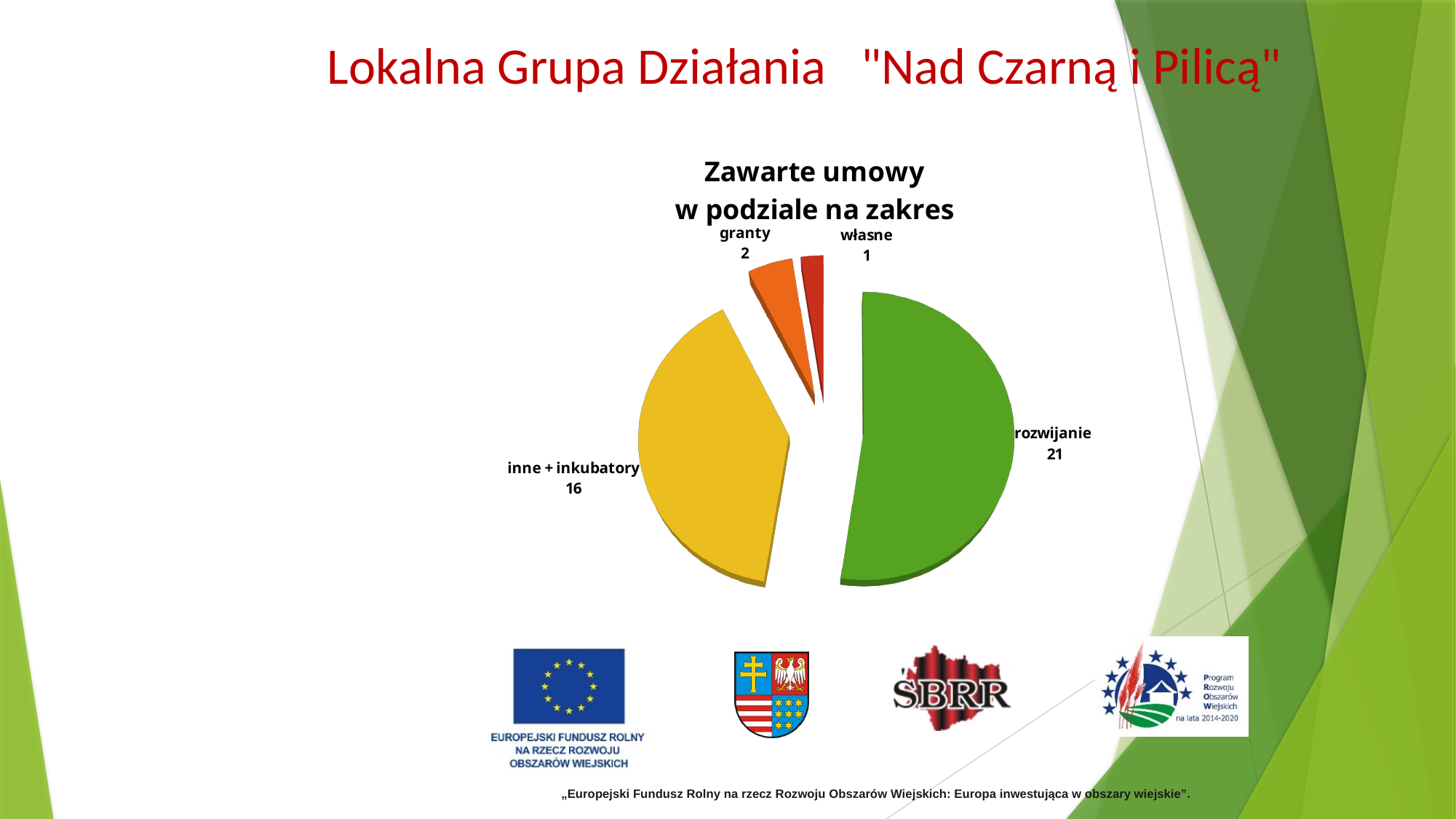
How many slices does the pie chart have? 4 What type of chart is shown on the slide? pie chart What is the value for własne? 1 Which is larger, granty or własne? granty What is the value for granty? 2 Which category has the largest slice? rozwijanie What is the difference between the values for rozwijanie and inne + inkubatory? 5 What is the title of the chart? Zawarte umowy w podziale na zakres What is the value for inne + inkubatory? 16 What share of the pie does inne + inkubatory represent? 40% Which category has the smallest slice? własne What is the value for rozwijanie? 21